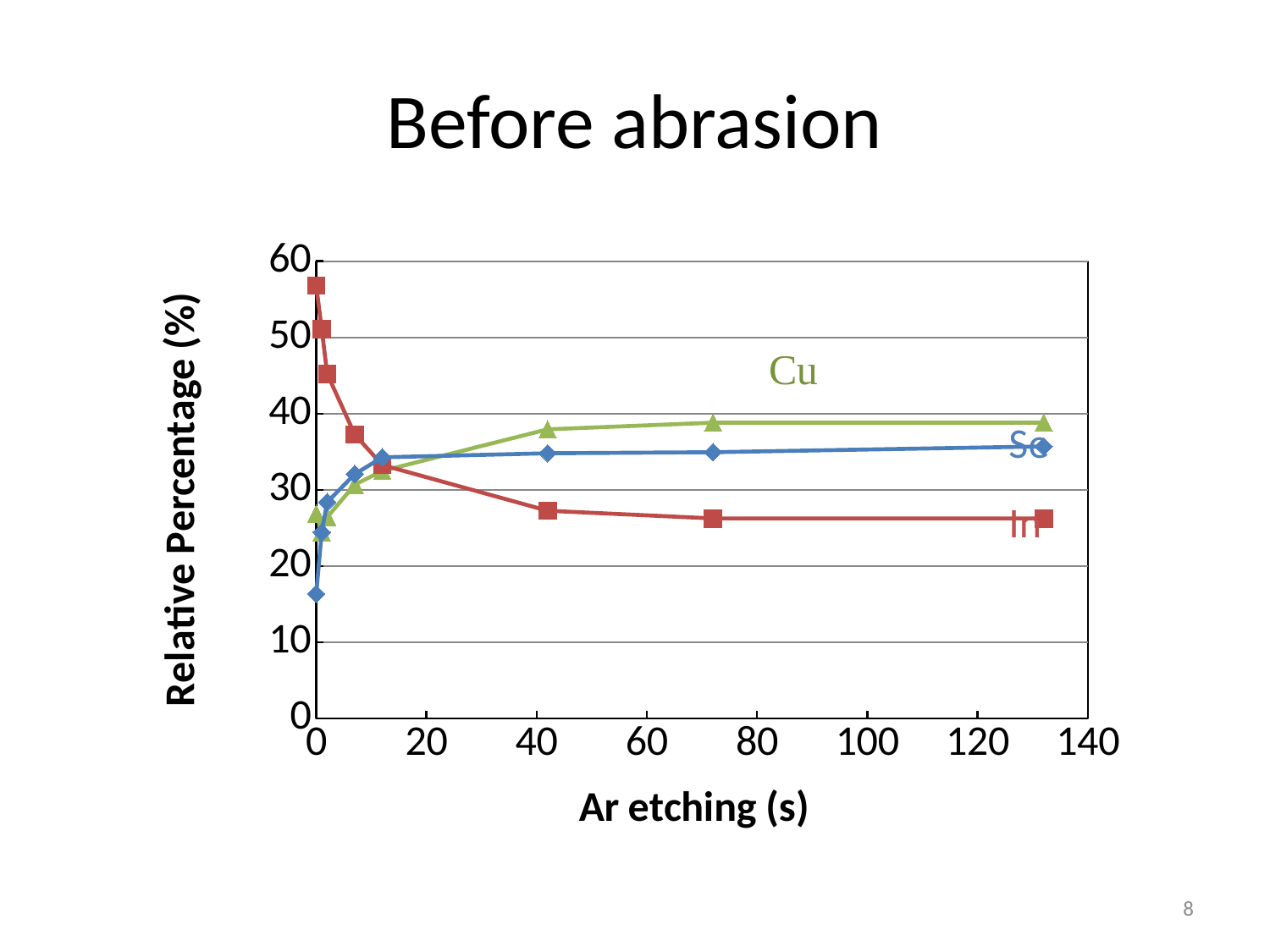
Is the value for In at 0 s greater or less than 50? greater At the last etching time (about 132 s), which is larger, Cu or Se? Cu Is the value for Se at 0 s greater or less than 20? less Does the Cu series rise or fall as Ar etching time increases? rise What kind of chart is shown on the slide? line chart What is the title of the chart? Before abrasion Is the value for In at about 132 s greater or less than 30? less What is the label of the x axis? Ar etching (s) Which series has the highest value at 0 s? In Does the In series rise or fall as Ar etching time increases? fall How many series are plotted on the chart? 3